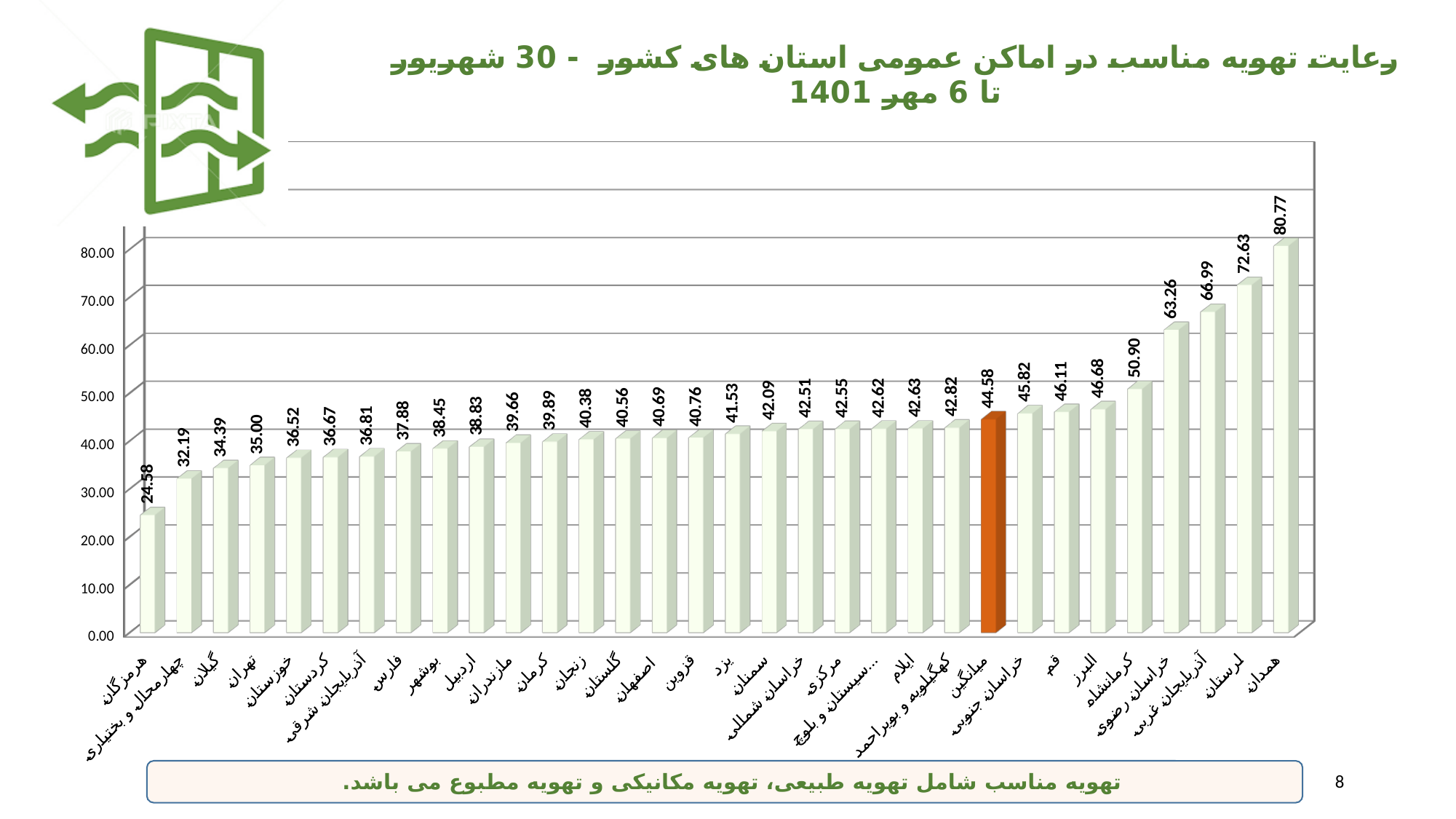
What is the value shown for the orange bar labelled میانگین? 44.58 Which has a larger value, خراسان رضوی or قم? خراسان رضوی What is the value shown for همدان? 80.77 How many bars are plotted in the chart? 32 What is the difference between the values for همدان and هرمزگان? 56.19 Do the values rise or fall moving from left to right along the x axis? rise What is the difference between the values for لرستان and کرمانشاه? 21.73 Is the value for آذربایجان غربی greater or less than 60.00? greater What is the value shown for تهران? 35.00 Which category has the lowest value? هرمزگان Which category has the highest value? همدان What kind of chart is shown on the slide? bar chart